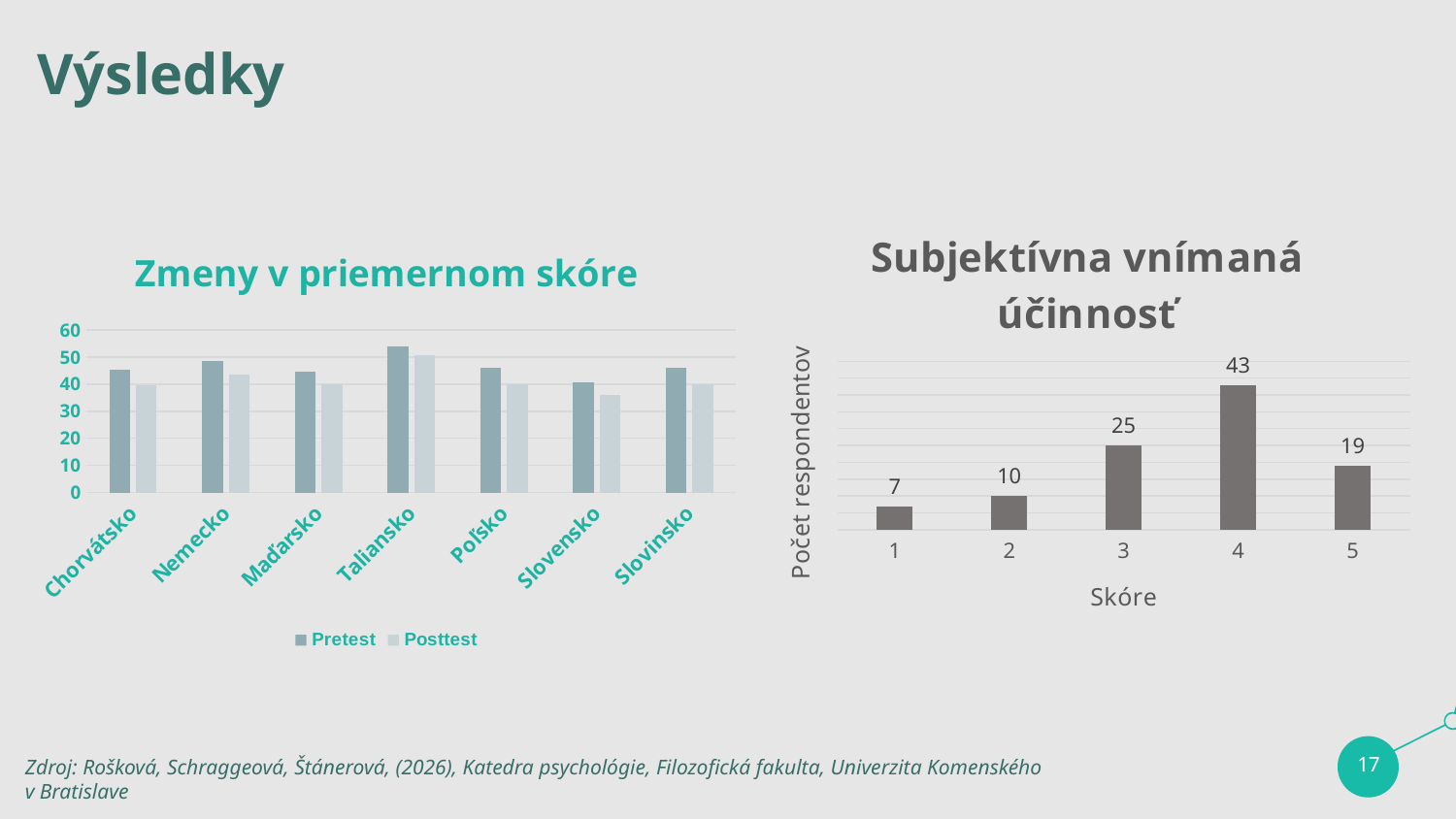
How many countries are shown in the chart 'Zmeny v priemernom skóre'? 7 In the chart 'Subjektívna vnímaná účinnosť', what is the difference between the number of respondents for score 4 and score 3? 18 In the chart 'Subjektívna vnímaná účinnosť', which score has the lowest number of respondents? 1 In the chart 'Zmeny v priemernom skóre', what are the two legend entries? Pretest, Posttest How many series does the legend of the chart 'Zmeny v priemernom skóre' list? 2 In the chart 'Subjektívna vnímaná účinnosť', which score has the highest number of respondents? 4 In the chart 'Zmeny v priemernom skóre', which country has the highest Pretest value? Taliansko In the chart 'Subjektívna vnímaná účinnosť', which has more respondents: score 3 or score 5? 3 In the chart 'Subjektívna vnímaná účinnosť', how many respondents gave a score of 4? 43 In the chart 'Zmeny v priemernom skóre', is the Pretest value for Taliansko greater or less than 50? greater What kind of chart is 'Zmeny v priemernom skóre'? bar chart How many score categories are shown in the chart 'Subjektívna vnímaná účinnosť'? 5